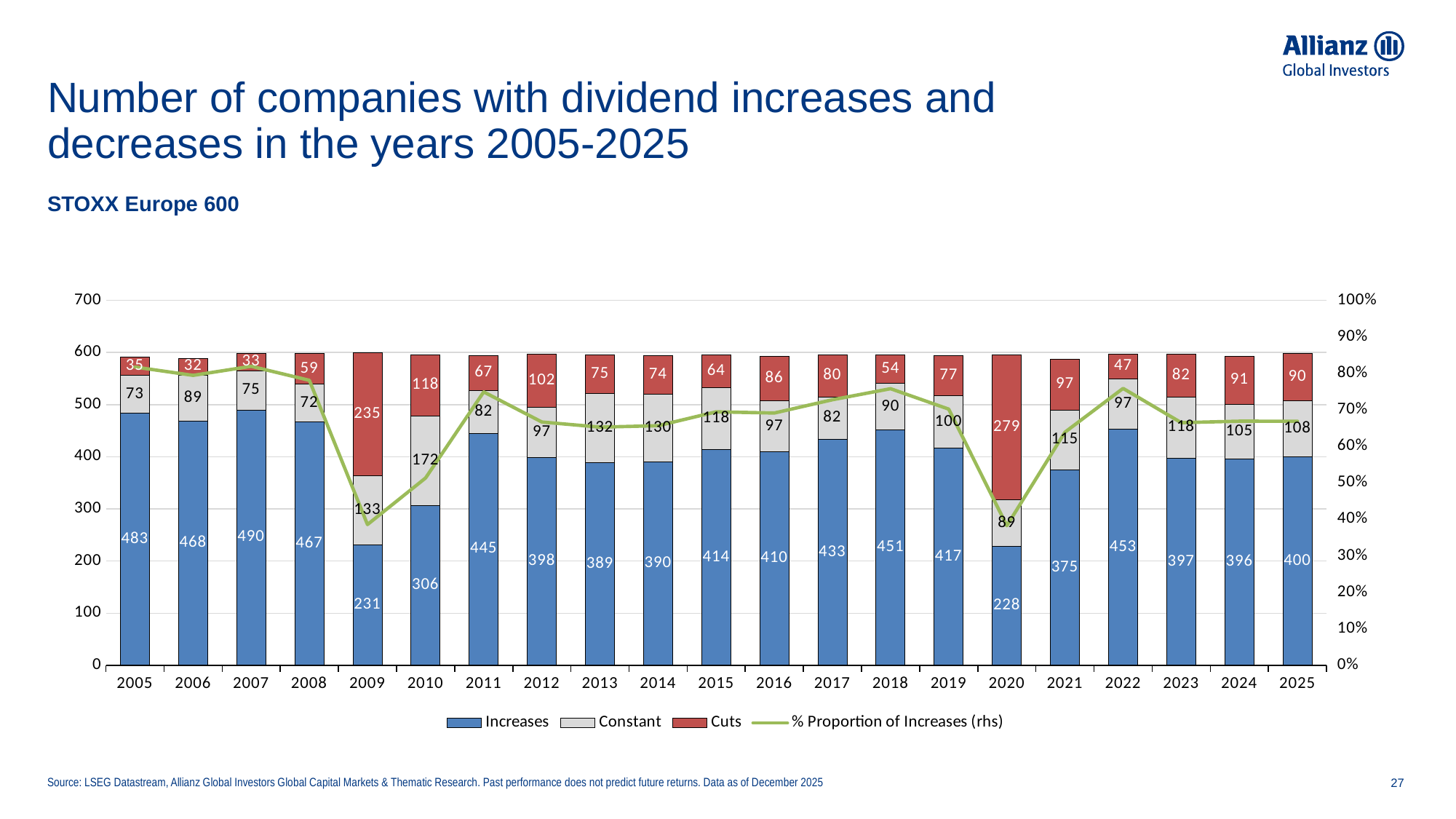
Which year has the lowest value for Cuts? 2006 What is the Constant value for 2010? 172 Which year has the lowest value for Increases? 2020 What is the value of the Cuts series for 2020? 279 What is the total of the stacked bar for 2025 (Increases, Constant and Cuts)? 598 How many years are shown on the x axis? 21 Which is larger, the Cuts value for 2009 or the Cuts value for 2010? 2009 How many series does the legend list? 4 How many companies had dividend increases in 2007? 490 Which year has the highest value for Cuts? 2020 Is the % Proportion of Increases for 2009 greater or less than 50%? less What is the difference between the Increases values for 2022 and 2021? 78